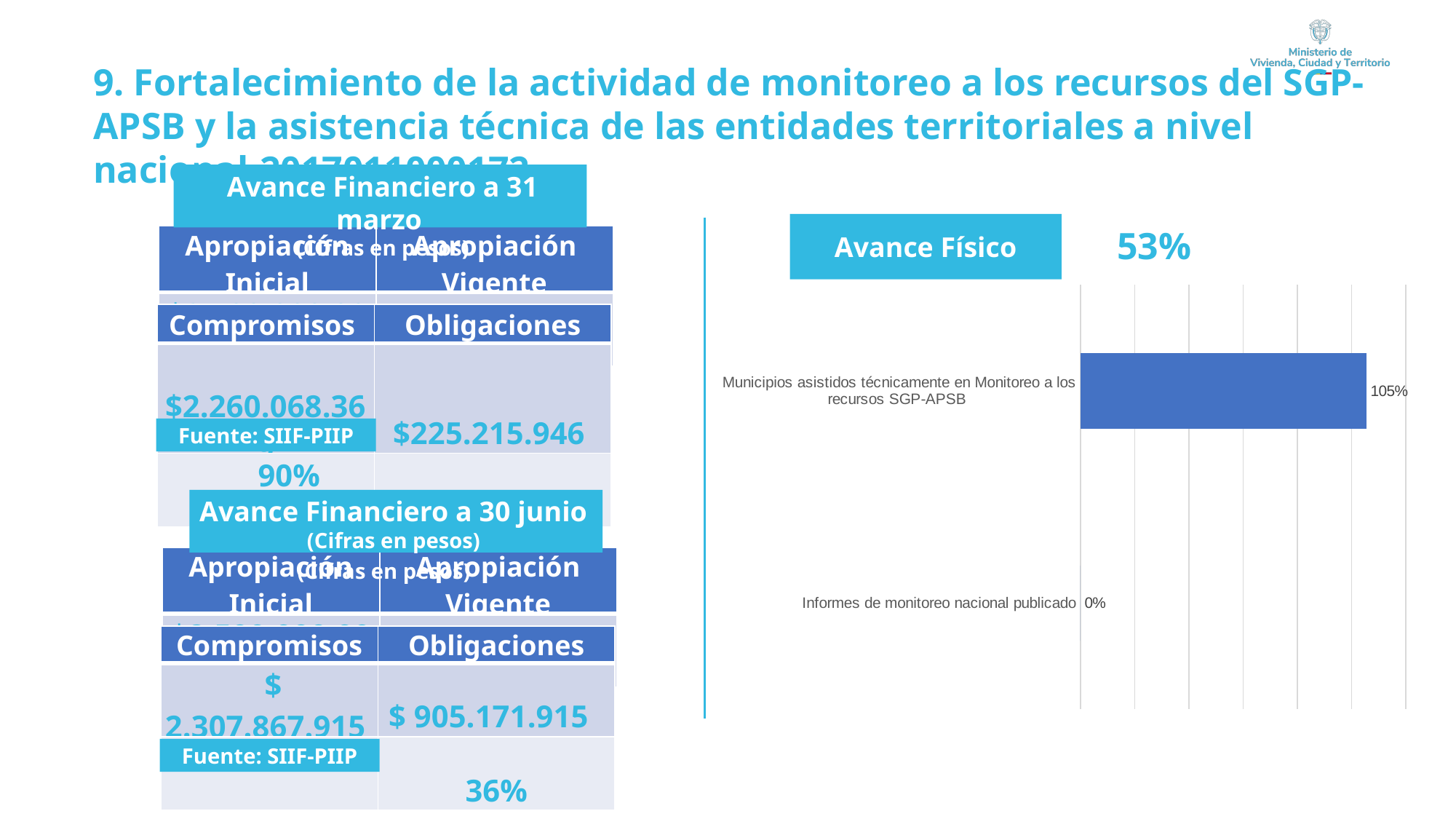
In the bar chart on the right, what is the value for "Municipios asistidos técnicamente en Monitoreo a los recursos SGP-APSB"? 105% What percentage is shown next to the "Avance Físico" label above the bar chart? 53% In the bar chart on the right, what is the difference between the value for "Municipios asistidos técnicamente en Monitoreo a los recursos SGP-APSB" and the value for "Informes de monitoreo nacional publicado"? 105% In the bar chart on the right, which is larger: the value for "Municipios asistidos técnicamente en Monitoreo a los recursos SGP-APSB" or the value for "Informes de monitoreo nacional publicado"? Municipios asistidos técnicamente en Monitoreo a los recursos SGP-APSB What colour are the bars in the bar chart on the right? blue In the bar chart on the right, which category has the lowest value? Informes de monitoreo nacional publicado In the bar chart on the right, which category has the highest value? Municipios asistidos técnicamente en Monitoreo a los recursos SGP-APSB In the bar chart on the right, what is the value for "Informes de monitoreo nacional publicado"? 0% How many categories are plotted in the bar chart on the right? 2 What kind of chart is shown on the right side of the slide under "Avance Físico"? bar chart